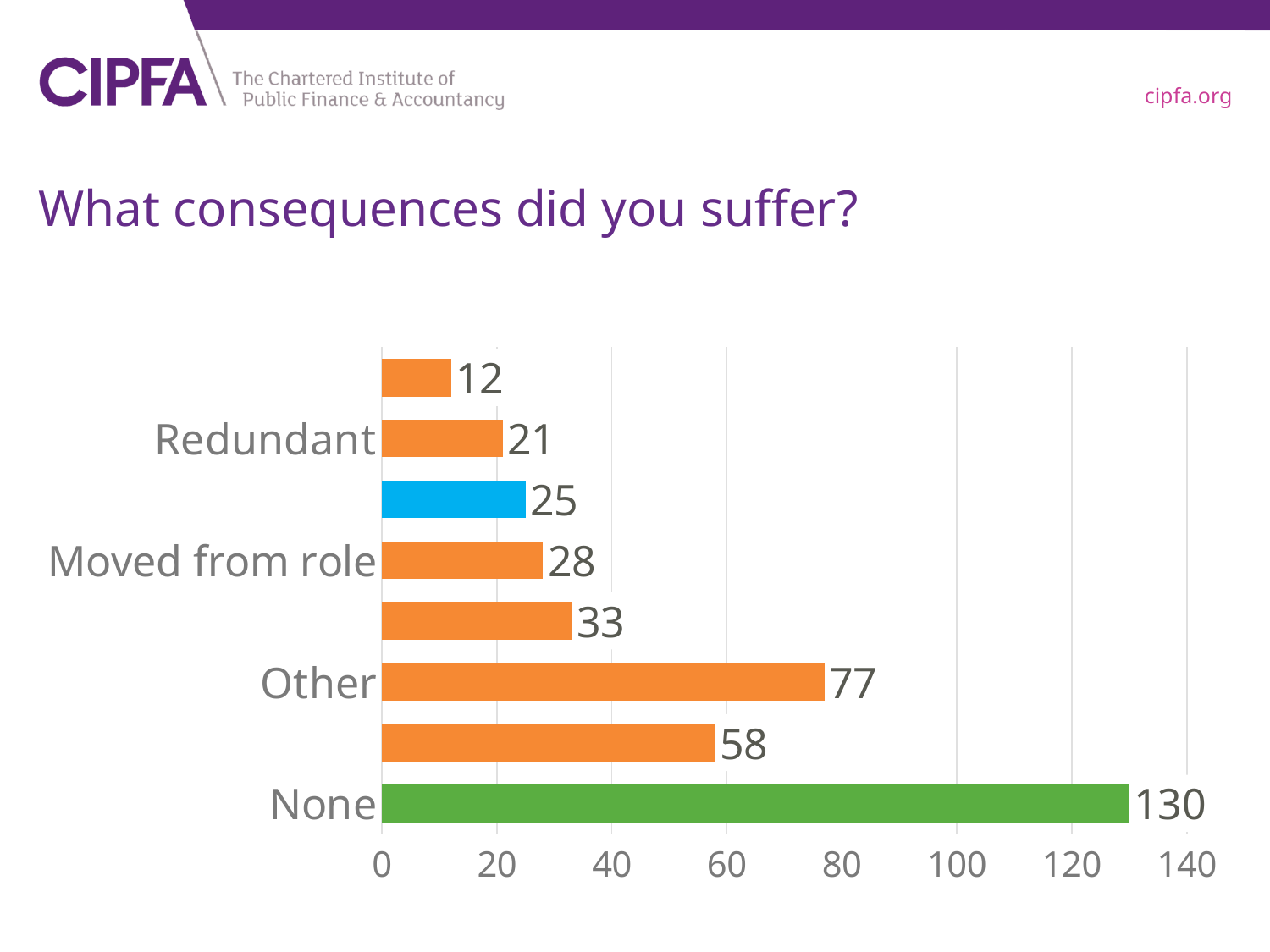
What is the title of the slide above the chart? What consequences did you suffer? What kind of chart is shown on the slide? bar chart What is the value for None? 130 What is the value for Redundant? 21 Which labelled category has the highest value? None Which is larger, the value for Other or the value for Moved from role? Other How many bars are plotted in the chart? 8 What is the value for Moved from role? 28 What is the difference between the values for Moved from role and Redundant? 7 Which labelled category has the lowest value? Redundant What is the difference between the values for None and Other? 53 What is the value for Other? 77